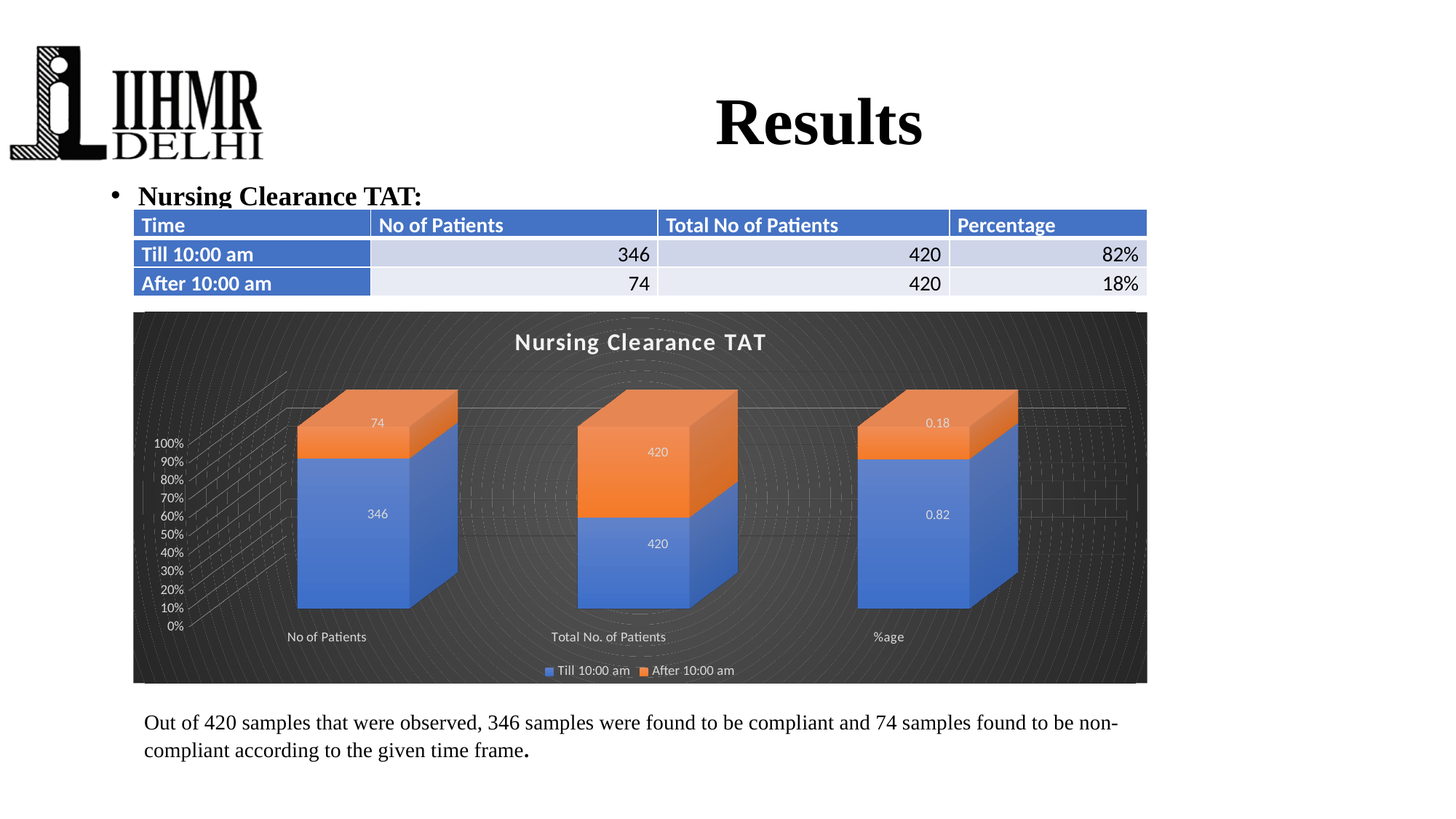
What is the value of the After 10:00 am series for %age? 0.18 Which colour represents the After 10:00 am series in the chart? Orange What type of chart is shown on the slide? Stacked bar chart What is the value of the Till 10:00 am series for %age? 0.82 How many categories are shown on the x axis of the chart? 3 For No of Patients, which series has the larger value, Till 10:00 am or After 10:00 am? Till 10:00 am What is the value of the After 10:00 am series for No of Patients? 74 How many series does the chart legend list? 2 What is the value of the Till 10:00 am series for No of Patients? 346 What is the title of the chart? Nursing Clearance TAT What is the difference between the Till 10:00 am and After 10:00 am values for No of Patients? 272 What is the value of the After 10:00 am series for Total No. of Patients? 420